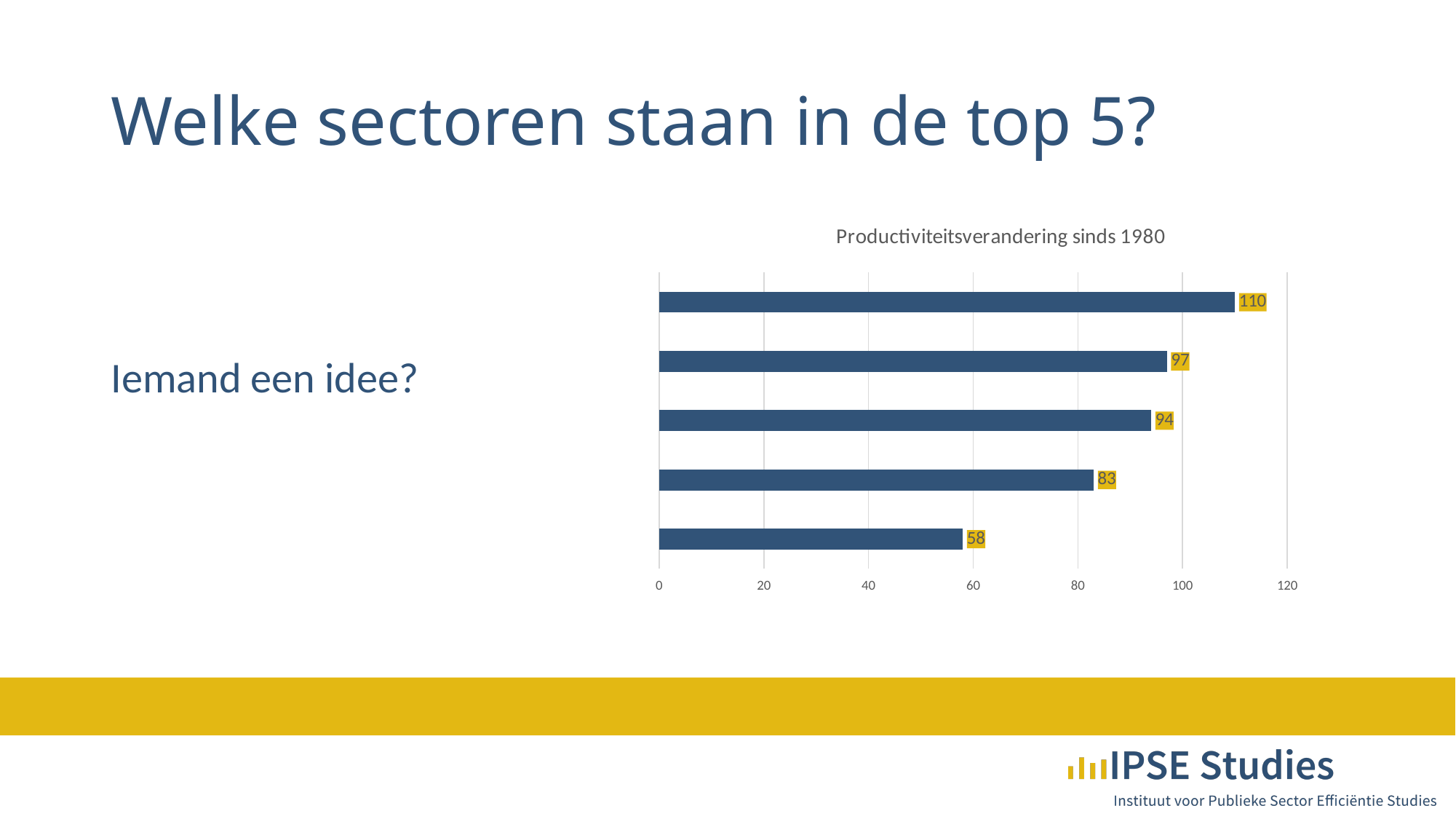
Is the value of the bottom bar greater or less than 60? less Which is larger, the value of the second bar from the top or the value of the fourth bar from the top? the second bar (97) What is the difference between the second bar (97) and the fourth bar (83)? 14 What is the value of the third bar from the top? 94 What is the title of the chart? Productiviteitsverandering sinds 1980 What is the lowest value shown in the chart? 58 What is the highest value shown in the chart? 110 What is the value of the bottom bar in the chart? 58 What kind of chart is shown on the slide? bar chart What is the difference between the top bar (110) and the bottom bar (58)? 52 What is the value of the top bar in the chart? 110 How many bars does the chart show? 5